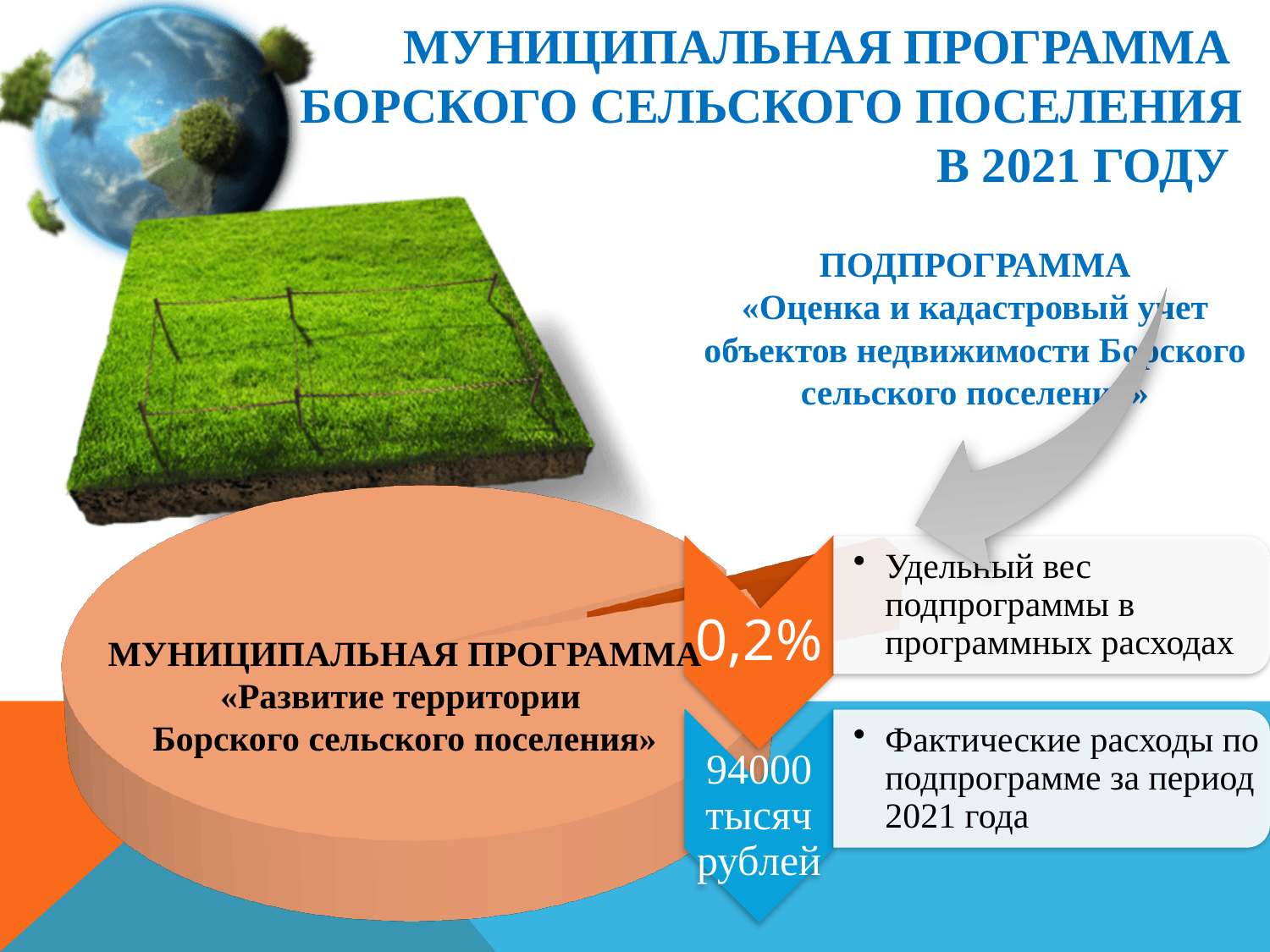
Is the subprogram's share of program expenses greater or less than 1%? less What colour is the small subprogram slice of the pie chart? orange How many slices does the pie chart have? 2 What kind of chart is shown on the slide? pie chart What share of the program expenses does the subprogram slice of the pie chart represent? 0,2% What does the 0,2% value on the pie chart represent, according to the slide? Удельный вес подпрограммы в программных расходах Which slice of the pie chart is larger: the municipal program «Развитие территории Борского сельского поселения» or the subprogram slice? the municipal program «Развитие территории Борского сельского поселения» What are the actual expenses for the subprogram for the 2021 period, as shown next to the pie chart? 94000 тысяч рублей